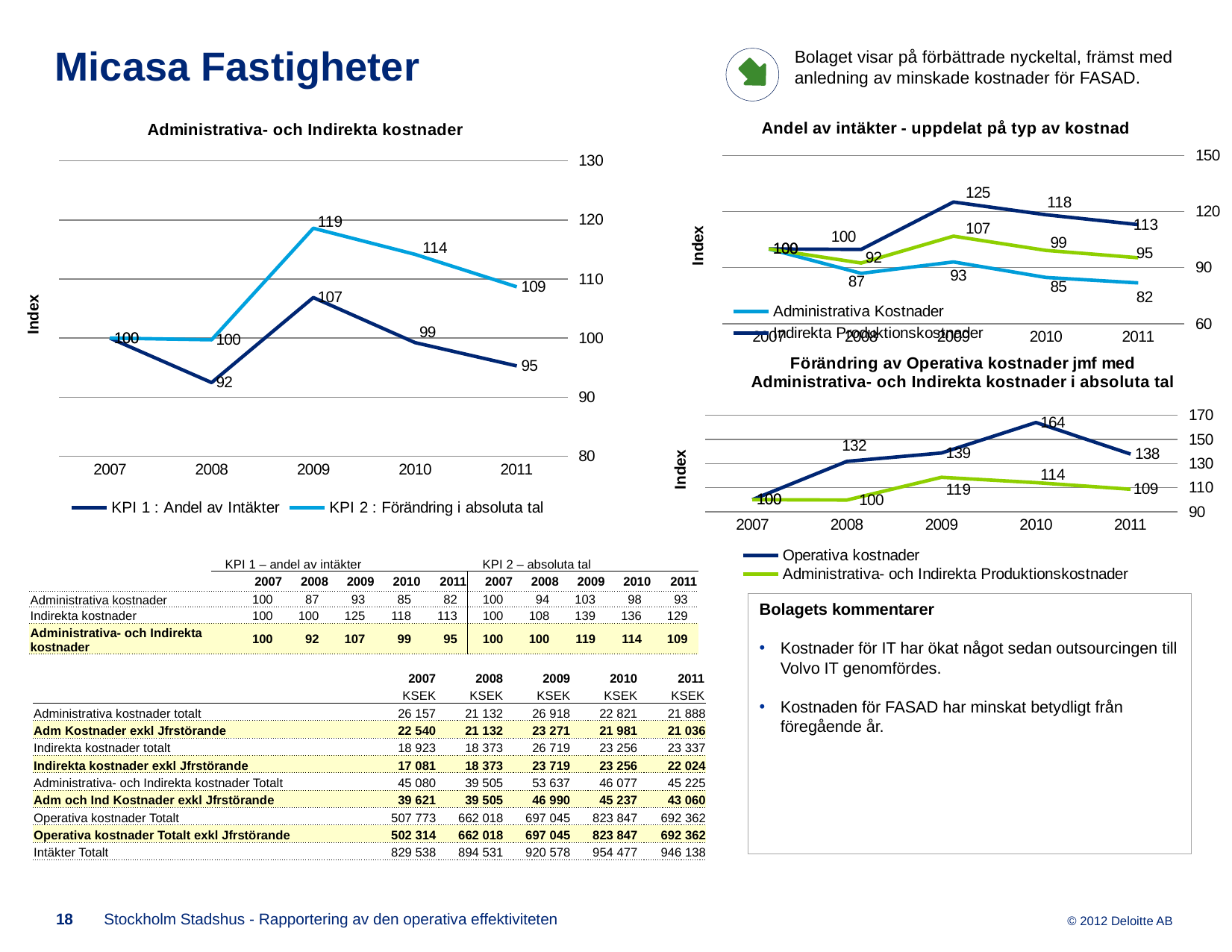
In the chart 'Andel av intäkter - uppdelat på typ av kostnad', what is the value of Administrativa Kostnader in 2011? 82 In the chart 'Andel av intäkter - uppdelat på typ av kostnad', in which year is Indirekta Produktionskostnader highest? 2009 What type of chart is 'Administrativa- och Indirekta kostnader'? Line chart In the chart 'Administrativa- och Indirekta kostnader', how many series does the legend list? 2 In the chart 'Administrativa- och Indirekta kostnader', what is the value of KPI 1 : Andel av Intäkter in 2008? 92 In the chart 'Administrativa- och Indirekta kostnader', in which year is KPI 1 : Andel av Intäkter lowest? 2008 In the chart 'Administrativa- och Indirekta kostnader', what is the value of KPI 2 : Förändring i absoluta tal in 2009? 119 In the chart 'Administrativa- och Indirekta kostnader', what is the difference between KPI 2 and KPI 1 in 2011? 14 In the chart 'Förändring av Operativa kostnader jmf med Administrativa- och Indirekta kostnader i absoluta tal', what is the difference between Operativa kostnader and Administrativa- och Indirekta Produktionskostnader in 2010? 50 In the chart 'Förändring av Operativa kostnader jmf med Administrativa- och Indirekta kostnader i absoluta tal', what is the value of Operativa kostnader in 2010? 164 In the chart 'Andel av intäkter - uppdelat på typ av kostnad', does Administrativa Kostnader rise or fall from 2009 to 2011? Fall In the chart 'Förändring av Operativa kostnader jmf med Administrativa- och Indirekta kostnader i absoluta tal', how many years are shown on the x axis? 5